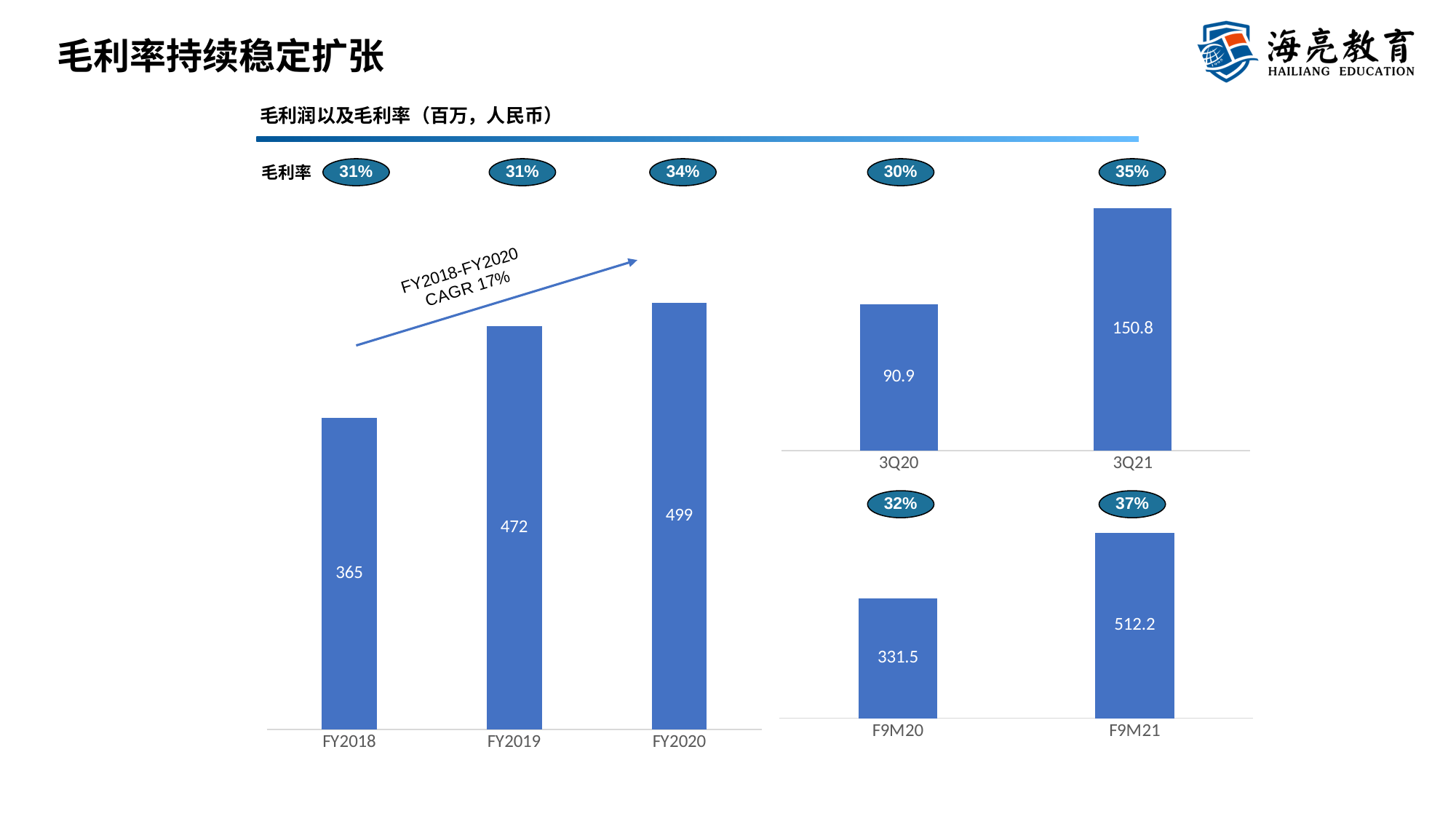
In the left chart (FY2018–FY2020), how many fiscal years are plotted? 3 What type of chart is used on this slide to show gross profit? bar chart In the top-right chart (3Q20 vs 3Q21), what is the gross profit value for 3Q21? 150.8 In the bottom-right chart (F9M20 vs F9M21), which period has the larger gross profit, F9M20 or F9M21? F9M21 In the left chart (FY2018–FY2020), do the gross profit values rise or fall from FY2018 to FY2020? rise In the left chart (FY2018–FY2020), which fiscal year has the lowest gross profit? FY2018 In the top-right chart (3Q20 vs 3Q21), what is the difference between the 3Q21 and 3Q20 gross profit values? 59.9 In the left chart (FY2018–FY2020), what is the gross profit value for FY2019? 472 In the left chart (FY2018–FY2020), which fiscal year has the highest gross profit? FY2020 What gross margin (毛利率) is shown above the F9M21 bar in the bottom-right chart? 37% In the bottom-right chart (F9M20 vs F9M21), what is the gross profit value for F9M20? 331.5 In the left chart (FY2018–FY2020), what is the difference between the FY2020 and FY2018 gross profit values? 134